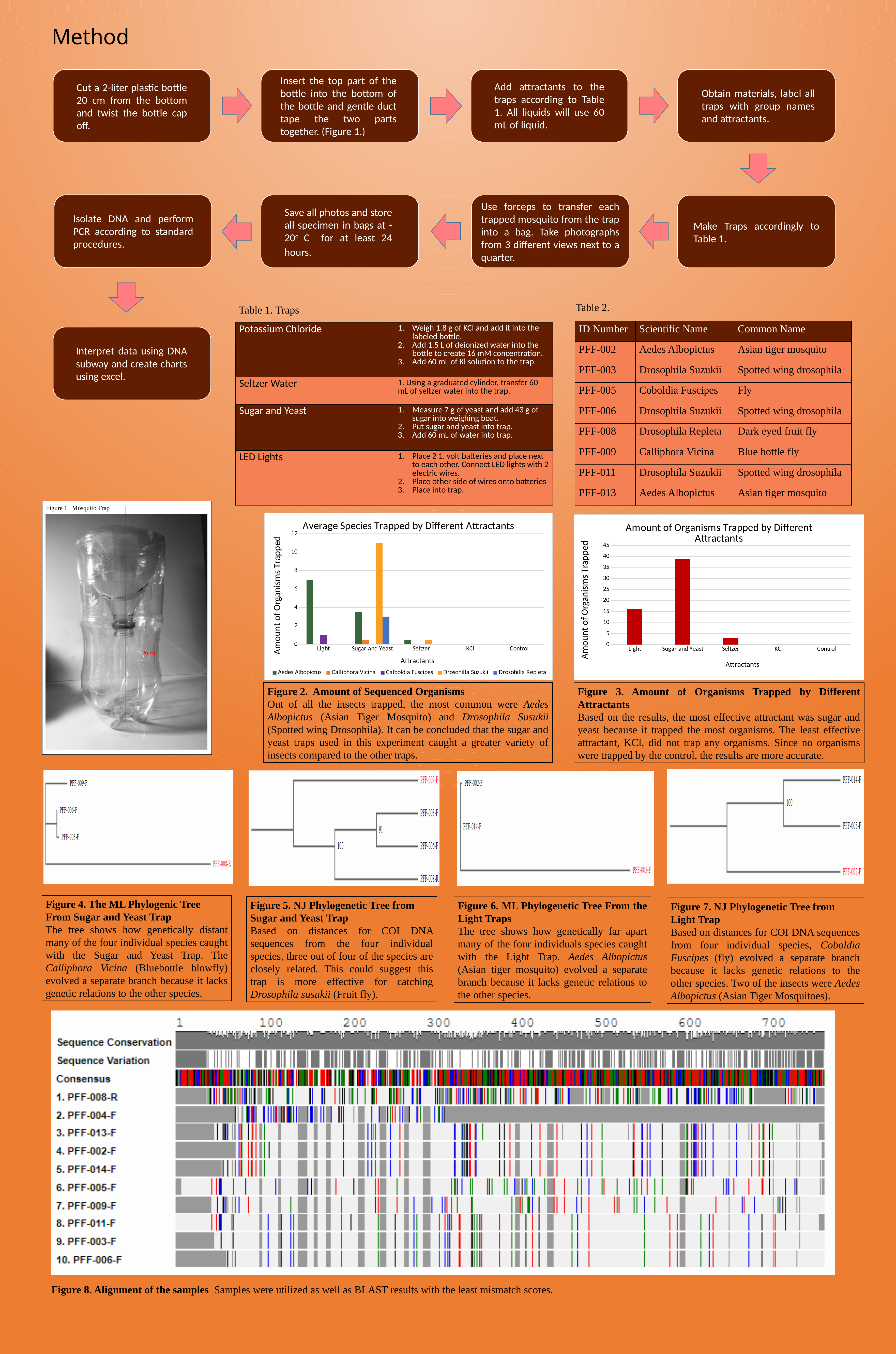
In the 'Amount of Organisms Trapped by Different Attractants' chart, which attractant has the highest bar? Sugar and Yeast In the 'Amount of Organisms Trapped by Different Attractants' chart, is the value for Seltzer greater or less than 5? less In the 'Average Species Trapped by Different Attractants' chart, which series has the tallest bar overall? Drosohilla Suzukii In the 'Amount of Organisms Trapped by Different Attractants' chart, is the value for Light greater or less than 20? less In the 'Average Species Trapped by Different Attractants' chart, is the value for Drosohilla Suzukii at Sugar and Yeast greater or less than 10? greater How many series does the legend list in the 'Average Species Trapped by Different Attractants' chart? 5 In the 'Average Species Trapped by Different Attractants' chart, which is larger, the Aedes Albopictus value for Light or for Sugar and Yeast? Light In the 'Amount of Organisms Trapped by Different Attractants' chart, which is larger, the value for Light or the value for Seltzer? Light What kind of chart is the 'Amount of Organisms Trapped by Different Attractants' chart? bar chart How many attractant categories are shown on the x axis of the 'Amount of Organisms Trapped by Different Attractants' chart? 5 What is the y-axis label of the 'Average Species Trapped by Different Attractants' chart? Amount of Organisms Trapped